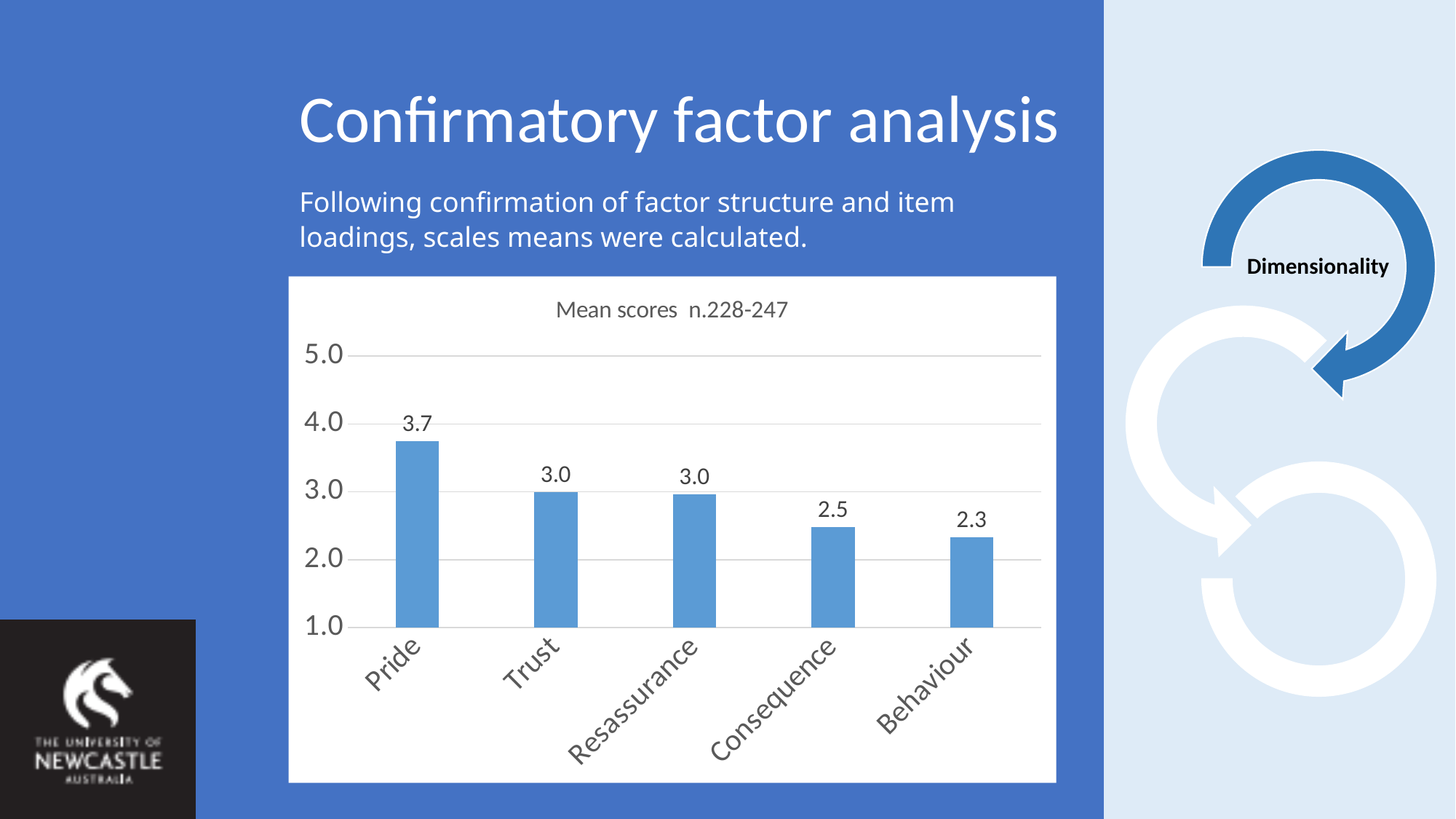
Which category has the highest mean score? Pride What is the difference between the mean scores for Pride and Behaviour? 1.4 What is the difference between the mean scores for Trust and Consequence? 0.5 Which category has the lowest mean score? Behaviour What is the mean score for Consequence? 2.5 What kind of chart is shown on the slide? Bar chart Which has a larger mean score, Consequence or Behaviour? Consequence What is the mean score for Behaviour? 2.3 What is the mean score for Pride? 3.7 What is the title of the chart? Mean scores n.228-247 How many categories are shown in the chart? 5 What is the mean score for Trust? 3.0